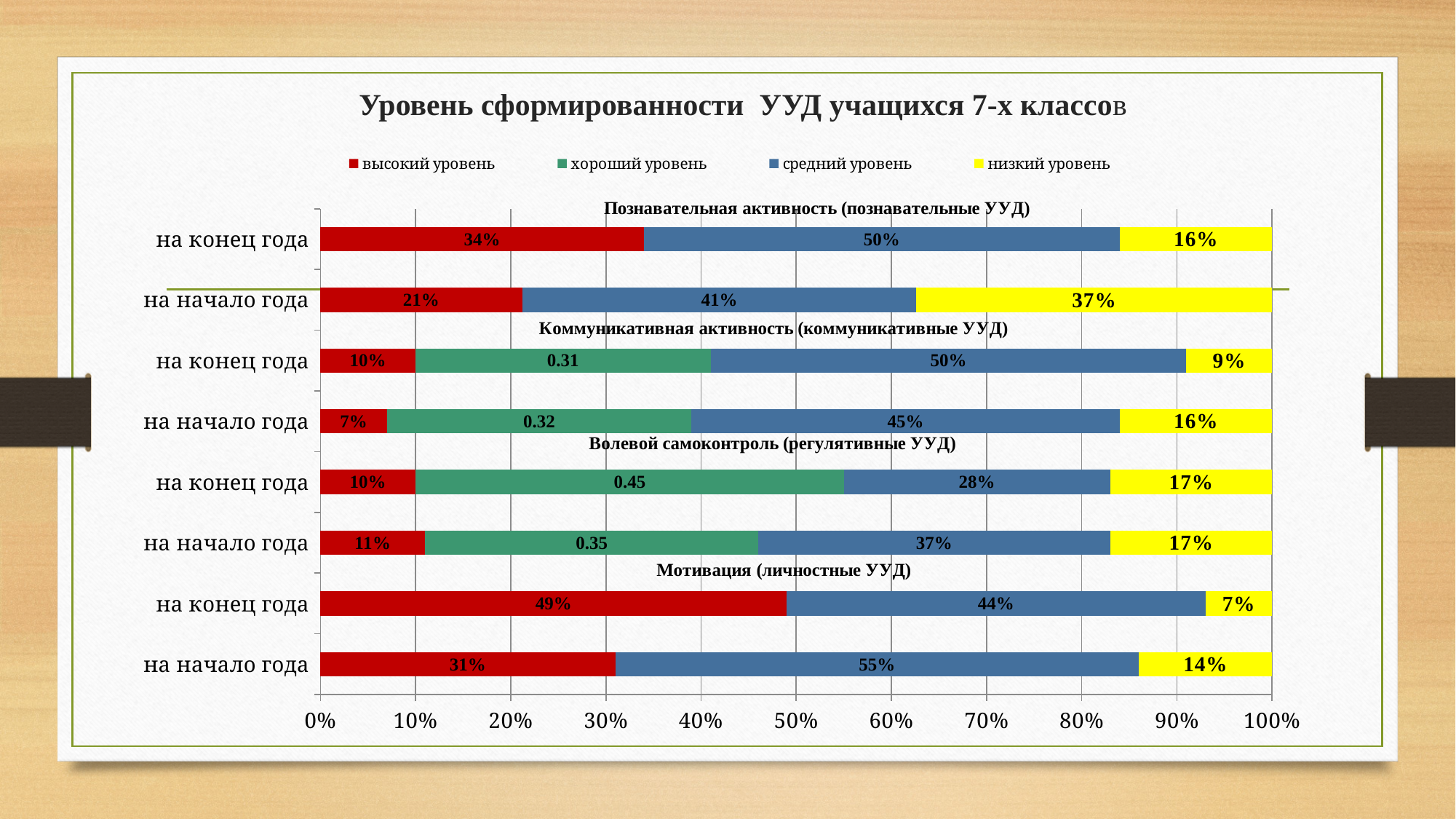
How many bars are plotted on the chart? 8 What is the value of the высокий уровень segment for 'на конец года' in the Познавательная активность group? 34% What label is printed on the хороший уровень segment for 'на конец года' in the Волевой самоконтроль group? 0.45 What is the value of the низкий уровень segment for 'на конец года' in the Коммуникативная активность group? 9% In the Мотивация group, what is the difference between the высокий уровень values for 'на конец года' and 'на начало года'? 18% What is the value of the низкий уровень segment for 'на начало года' in the Познавательная активность group? 37% In the Познавательная активность group, which has the larger низкий уровень value: 'на конец года' or 'на начало года'? на начало года Which colour represents низкий уровень in the legend? Yellow How many series does the legend list? 4 Which bar has the highest высокий уровень value on the chart? Мотивация, на конец года (49%) What is the value of the средний уровень segment for 'на конец года' in the Мотивация (личностные УУД) group? 44% What kind of chart is shown on the slide? Stacked bar chart